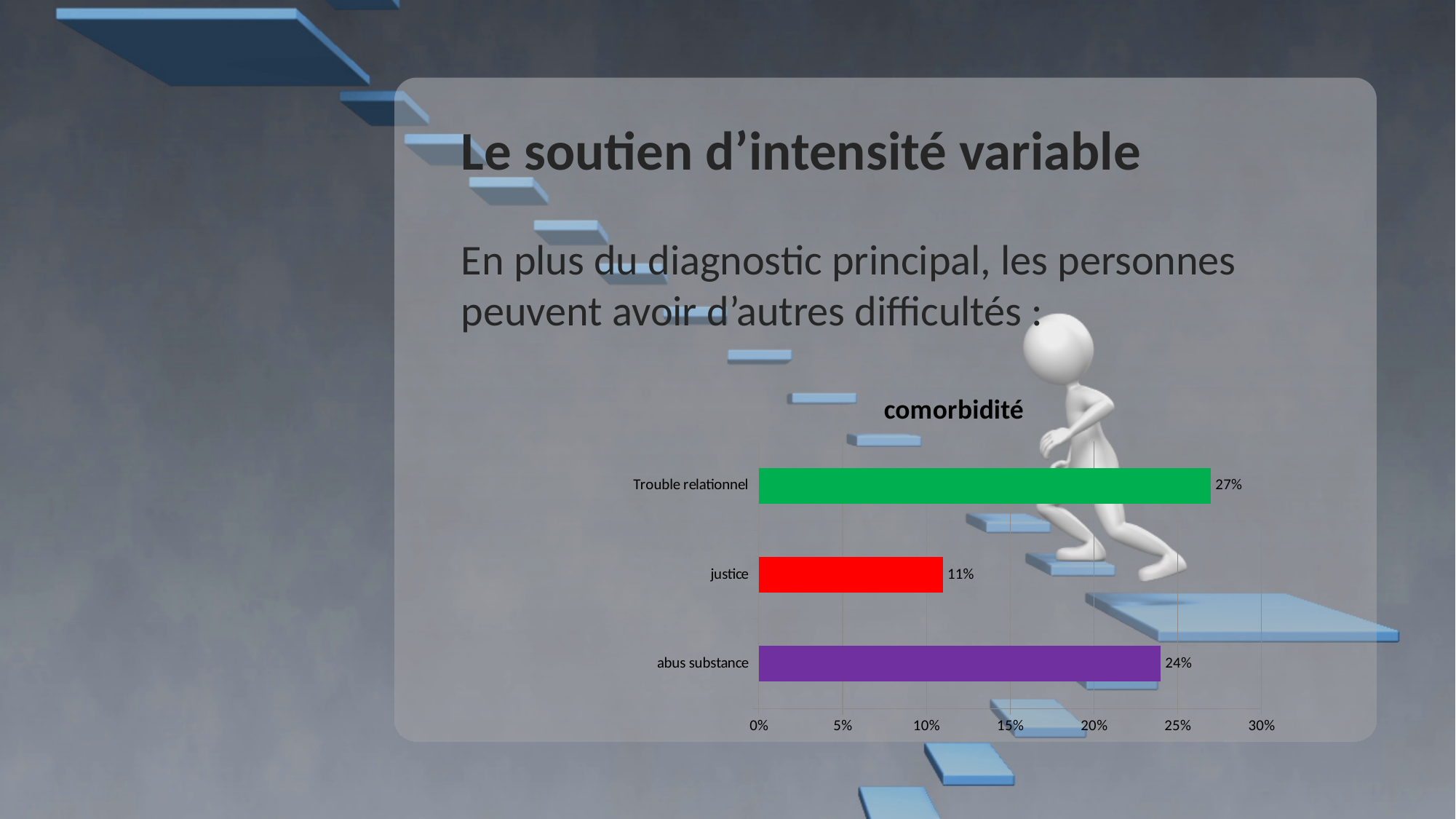
What is the value for abus substance? 24% What is the title of the chart? comorbidité What is the value for Trouble relationnel? 27% What kind of chart is shown on the slide? bar chart Which category has the highest value? Trouble relationnel What is the value for justice? 11% Is the value for abus substance greater or less than 20%? greater What is the difference between the values for abus substance and justice? 13% Which category has the lowest value? justice Which is larger, the value for abus substance or the value for justice? abus substance What is the difference between the values for Trouble relationnel and justice? 16% How many categories are shown in the chart? 3